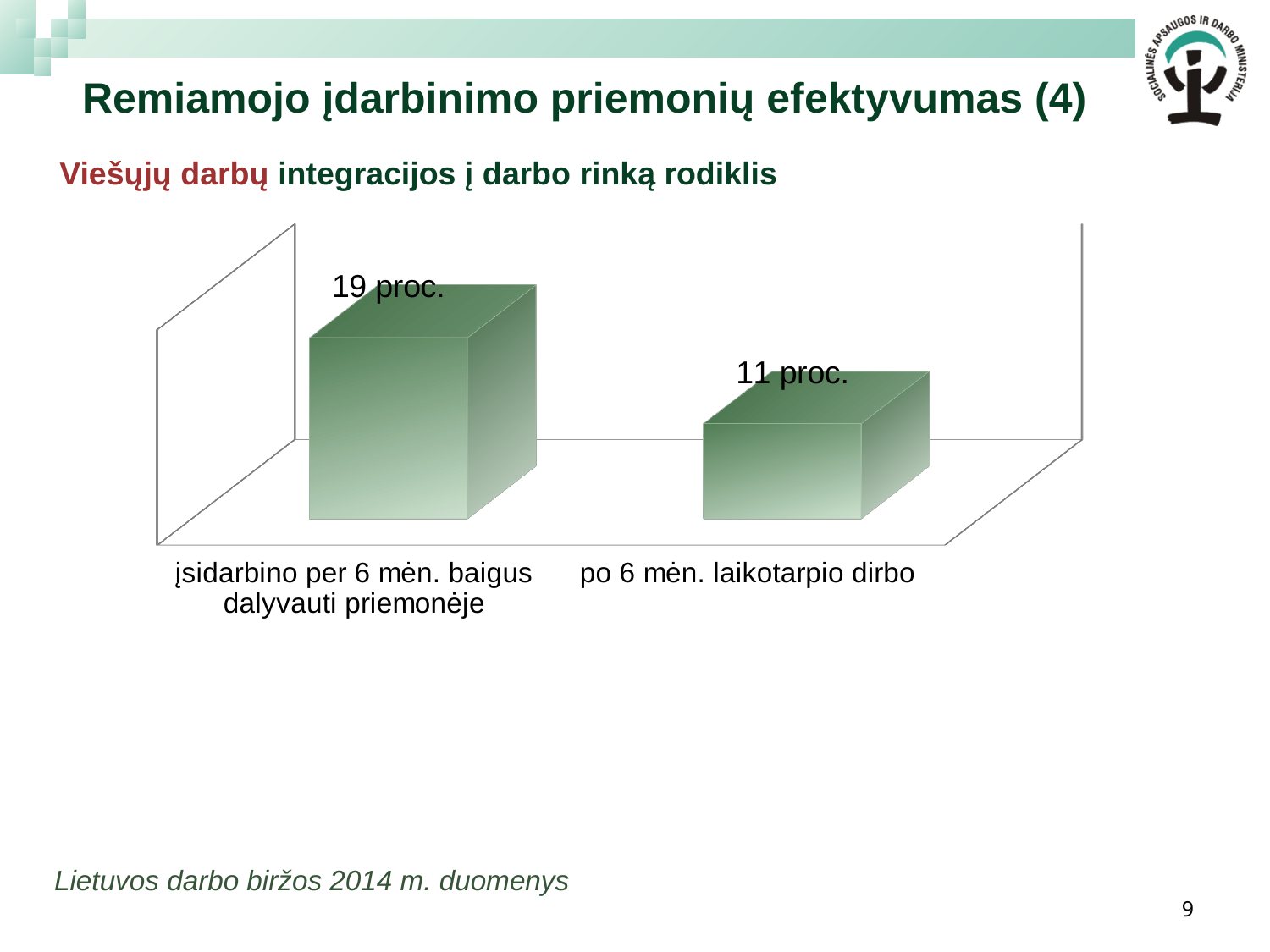
What is the value for "įsidarbino per 6 mėn. baigus dalyvauti priemonėje"? 19 proc. What is the title of the chart on the slide? Viešųjų darbų integracijos į darbo rinką rodiklis Which is larger: the value for "įsidarbino per 6 mėn. baigus dalyvauti priemonėje" or the value for "po 6 mėn. laikotarpio dirbo"? įsidarbino per 6 mėn. baigus dalyvauti priemonėje Which category has the highest value? įsidarbino per 6 mėn. baigus dalyvauti priemonėje What colour are the bars in the chart? green Which category has the lowest value? po 6 mėn. laikotarpio dirbo What is the difference between the value for "įsidarbino per 6 mėn. baigus dalyvauti priemonėje" and the value for "po 6 mėn. laikotarpio dirbo"? 8 proc. Do the values rise or fall from the left category to the right category? fall What kind of chart is shown on the slide? bar chart What is the value for "po 6 mėn. laikotarpio dirbo"? 11 proc. How many categories are shown in the chart? 2